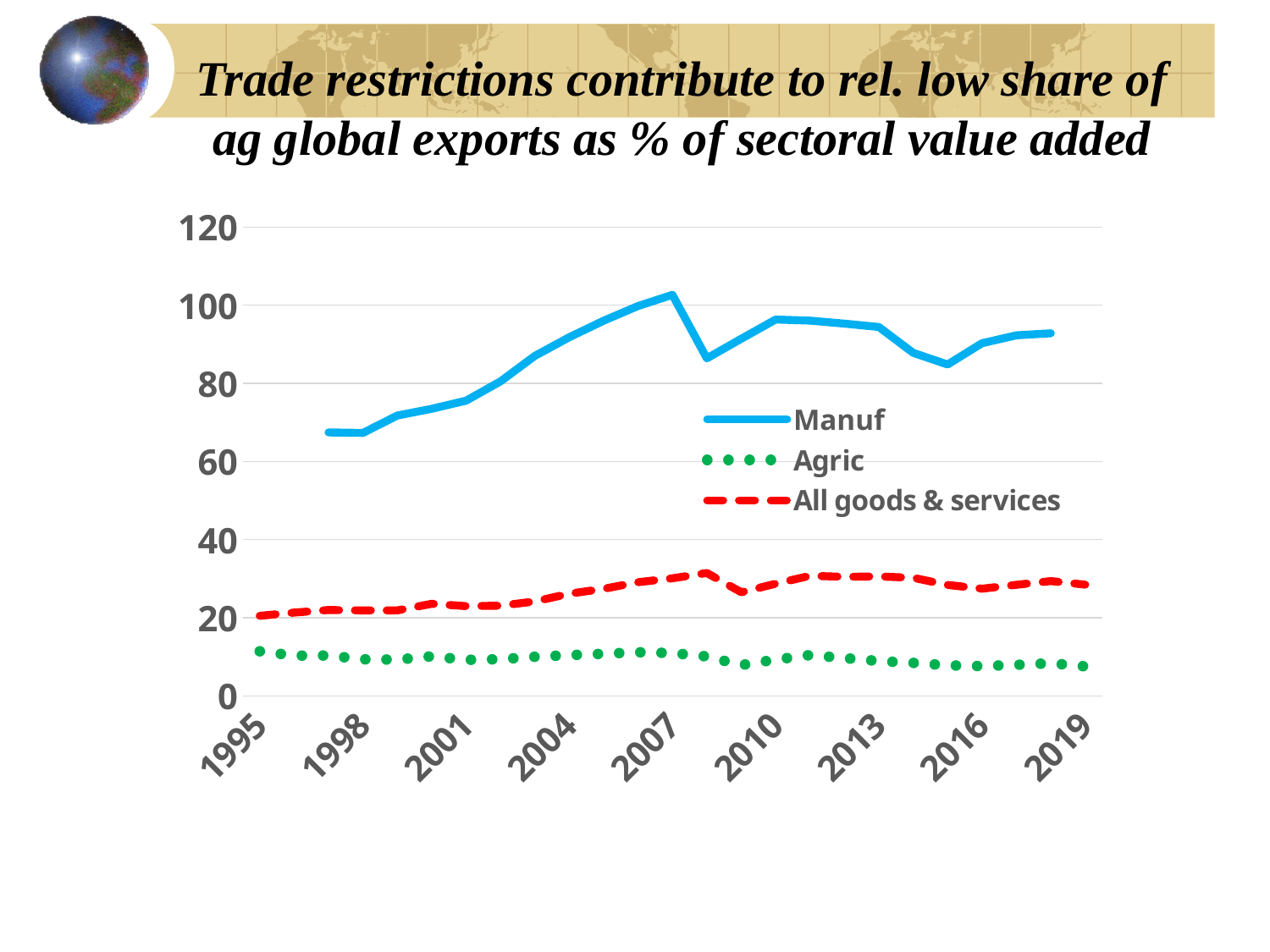
Which series has the lowest values throughout the chart? Agric Is the value for Manuf in 2007 greater or less than 80? greater How many series does the legend list? 3 Does the Manuf series rise or fall between 1997 and 2007? rise Which is larger in 2019, the value for All goods & services or the value for Agric? All goods & services Is the value for Agric in 2019 greater or less than 20? less Which series has the highest values throughout the chart? Manuf What kind of chart is shown on the slide? line chart Is the value for All goods & services in 1995 greater or less than 40? less Which series is drawn with a red dashed line? All goods & services Which is larger in 2010, the value for Manuf or the value for Agric? Manuf